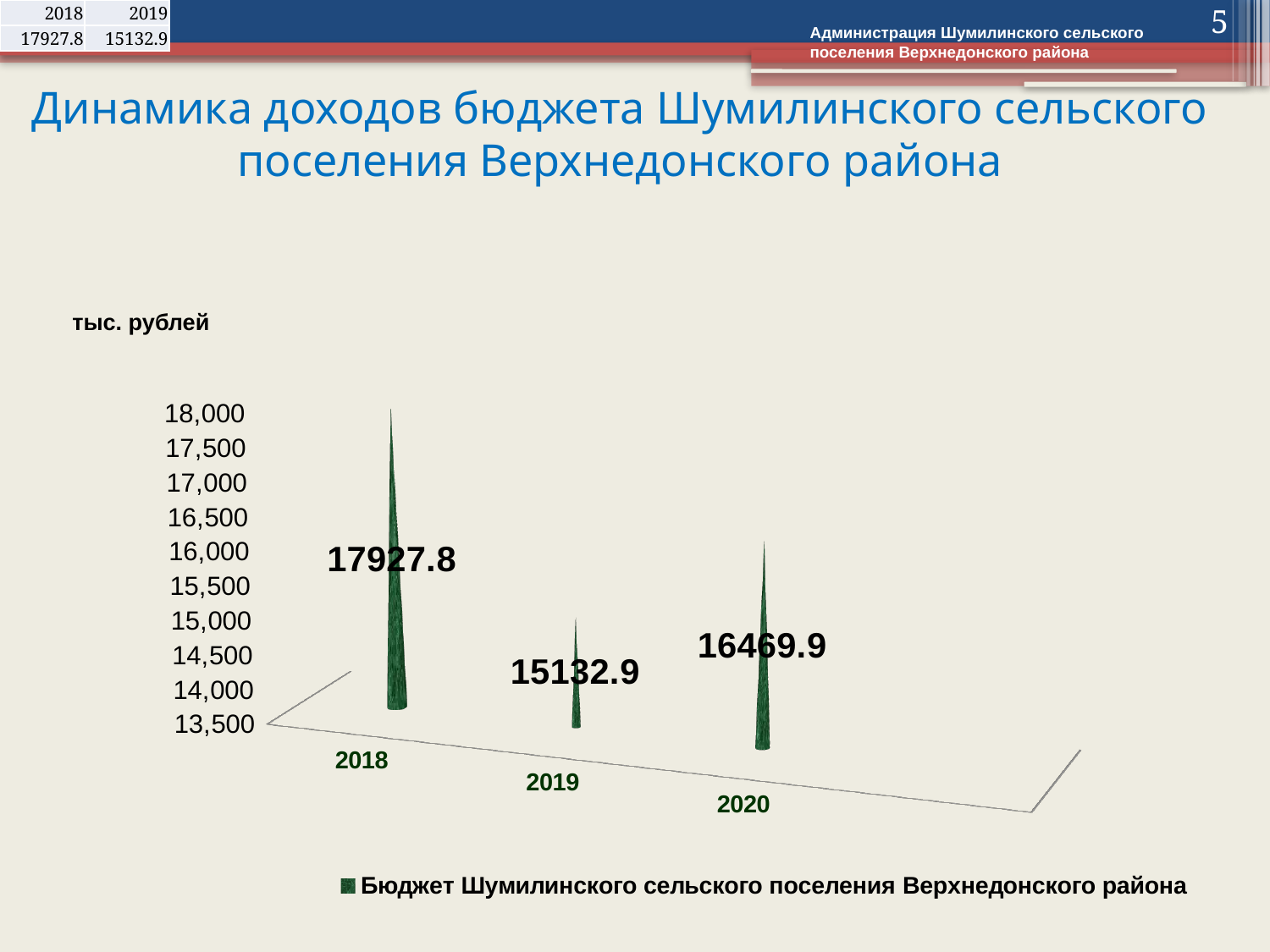
What kind of chart is shown on the slide? bar chart What is the value for 2018? 17927.8 How many series does the legend list? 1 Does the value rise or fall from 2018 to 2019? fall What is the difference between the values for 2020 and 2019? 1337.0 What is the value for 2020? 16469.9 What is the difference between the values for 2018 and 2019? 2794.9 Which is larger, the value for 2020 or the value for 2019? 2020 Which year has the highest value? 2018 What is the value for 2019? 15132.9 How many years are shown on the chart? 3 Which year has the lowest value? 2019